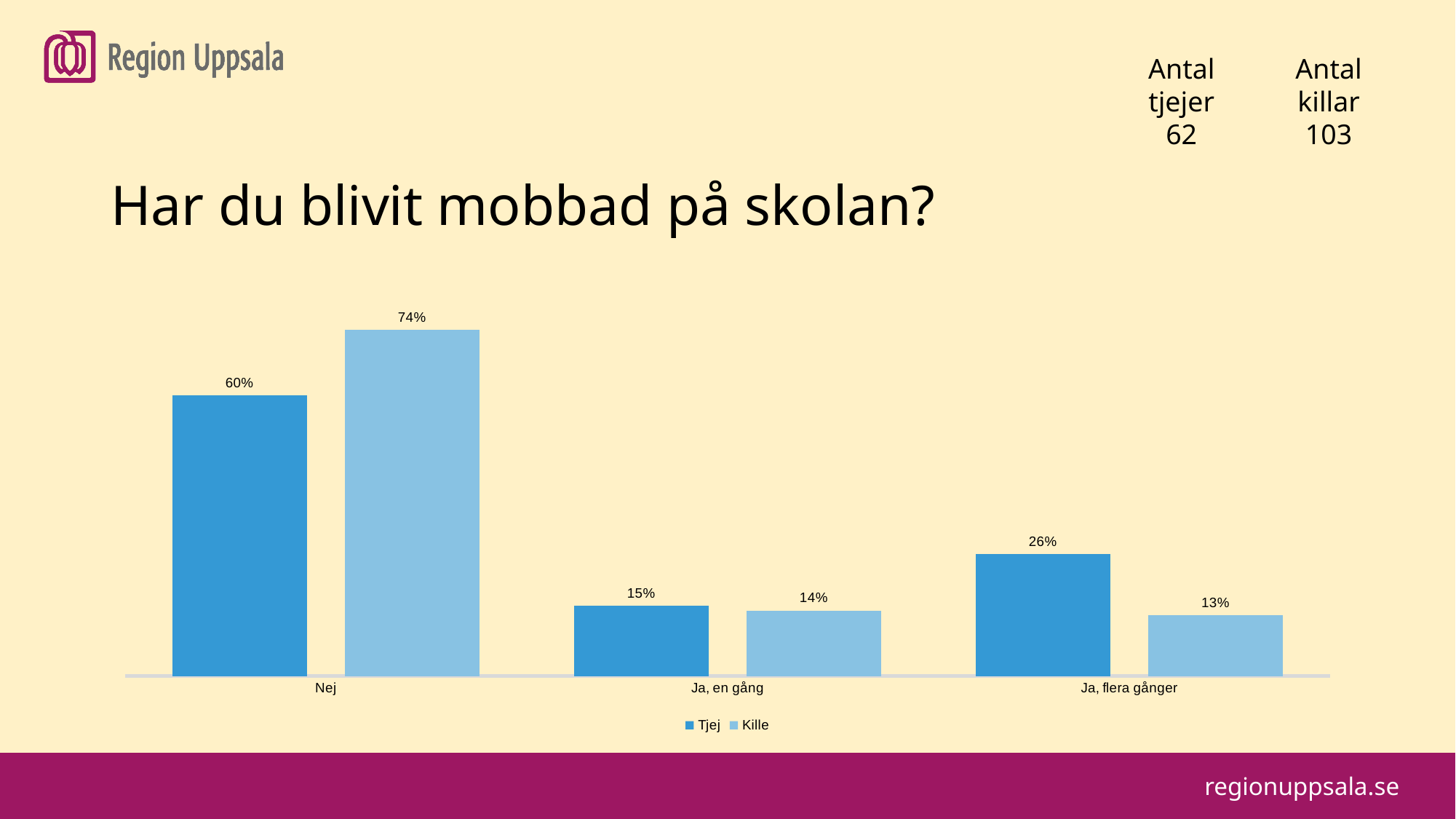
How many categories are shown on the x axis? 3 Which category has the lowest value for the Tjej series? Ja, en gång What is the difference between the Tjej and Kille values in the Ja, flera gånger category? 13% Which category has the highest value for the Kille series? Nej How many series does the legend list? 2 What is the value for Tjej in the Ja, flera gånger category? 26% What is the difference between the Kille and Tjej values in the Nej category? 14% What is the value for Kille in the Nej category? 74% What is the value for Tjej in the Nej category? 60% What is the value for Kille in the Ja, en gång category? 14% What kind of chart is shown on the slide? Bar chart In the Ja, flera gånger category, which series has the larger value, Tjej or Kille? Tjej